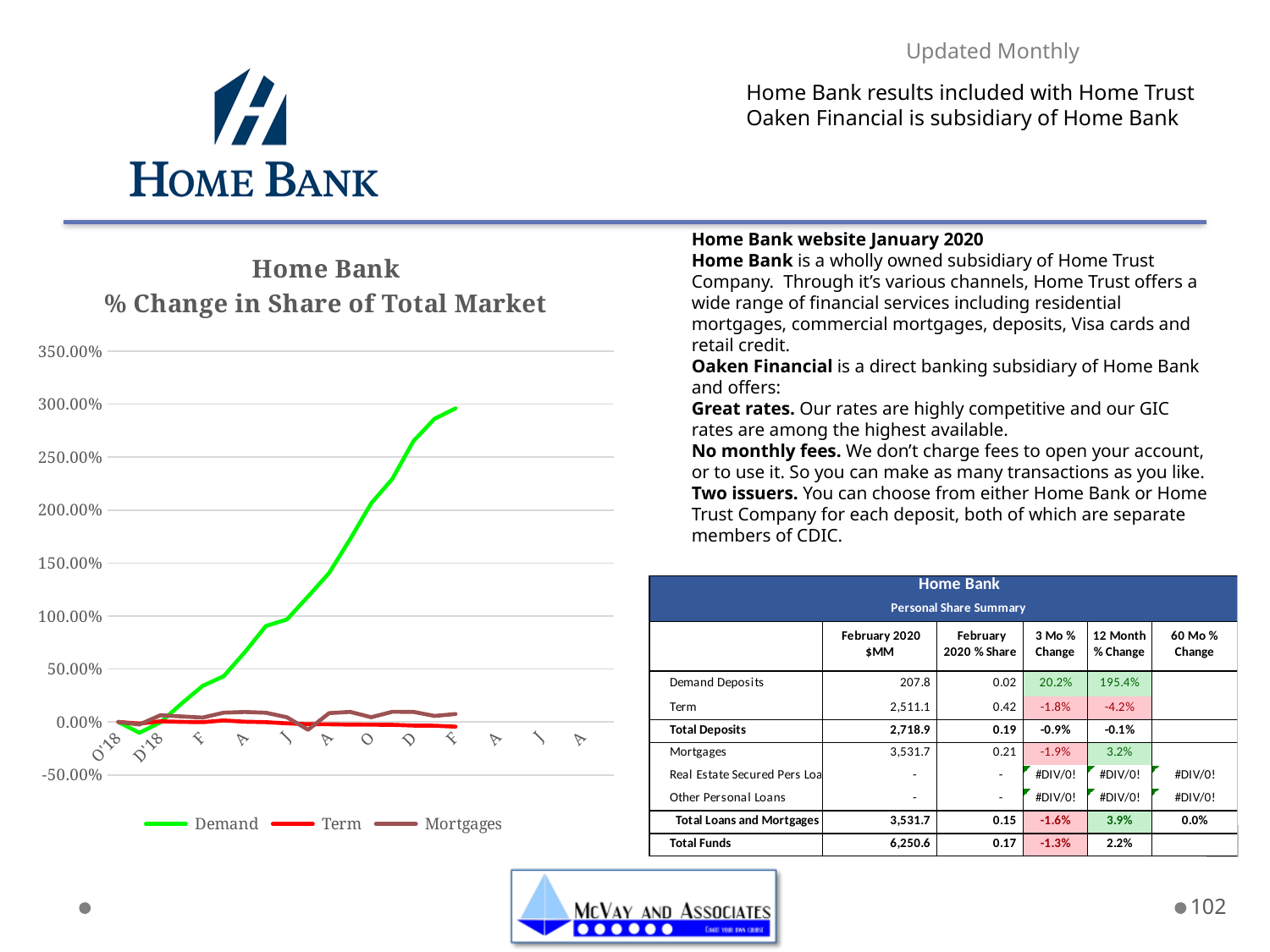
What is the title of the chart? Home Bank % Change in Share of Total Market Is the value for Term at the last plotted point greater or less than 50.00%? less Does the Demand series rise or fall over the period shown on the chart? rise Which series are listed in the chart's legend? Demand, Term, Mortgages What is the highest value shown on the chart's vertical axis? 350.00% Does the Mortgages series ever exceed 50.00% on the chart? No Which series reaches the highest value on the chart? Demand At the last plotted point, is the value for Demand greater or less than 250.00%? greater What kind of chart is shown on the slide? line chart How many series does the legend of the chart list? 3 At the last plotted point, which is larger, Demand or Term? Demand